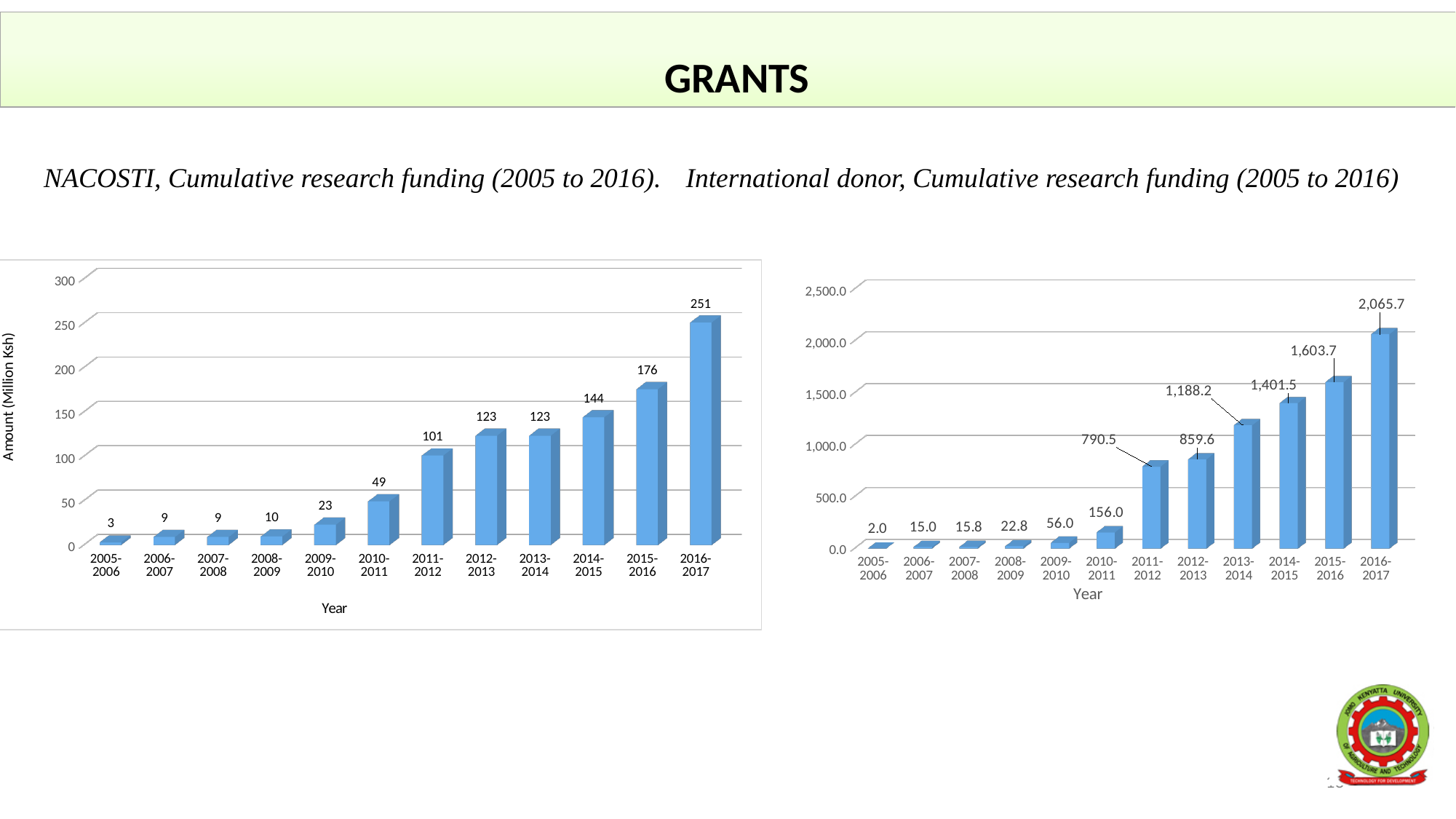
In the right chart (International donor cumulative research funding), what is the value for 2013-2014? 1,188.2 What kind of chart is the right chart (International donor cumulative research funding)? Bar chart In the right chart (International donor cumulative research funding), what is the value for 2009-2010? 56.0 In the right chart (International donor cumulative research funding), what is the difference between the values for 2012-2013 and 2011-2012? 69.1 How many years are shown on the x axis of the left chart (NACOSTI cumulative research funding)? 12 In the right chart (International donor cumulative research funding), which year has the highest value? 2016-2017 In the left chart (NACOSTI cumulative research funding), what is the difference between the values for 2016-2017 and 2015-2016? 75 In the left chart (NACOSTI cumulative research funding), what is the value for 2010-2011? 49 In the left chart (NACOSTI cumulative research funding), what is the label of the y axis? Amount (Million Ksh) In the left chart (NACOSTI cumulative research funding), what is the value for 2016-2017? 251 In the left chart (NACOSTI cumulative research funding), which is larger, the value for 2011-2012 or the value for 2014-2015? 2014-2015 In the left chart (NACOSTI cumulative research funding), which year has the lowest value? 2005-2006